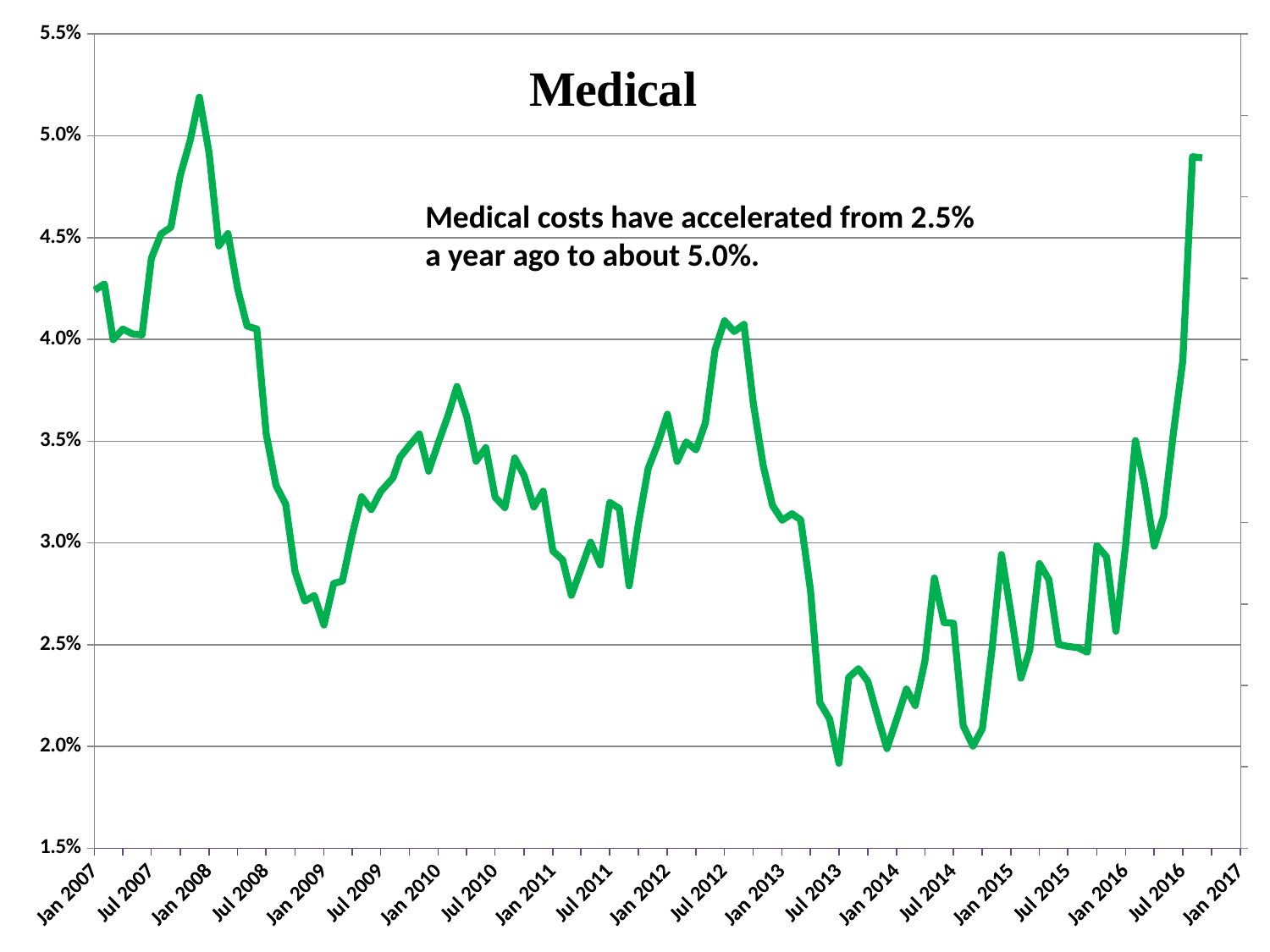
Is the value at Jan 2011 greater or less than 3.5%? less Is the value at Jan 2007 greater or less than 4.0%? greater What is the title of the chart? Medical Around which date does the line reach its highest point? Jan 2008 Is the value at Jan 2009 greater or less than 3.0%? less What colour is the plotted line? green What kind of chart is shown on the slide? line chart Which is larger, the value at Jan 2008 or the value at Jan 2009? Jan 2008 Does the line rise or fall between Jan 2016 and Jul 2016? rise